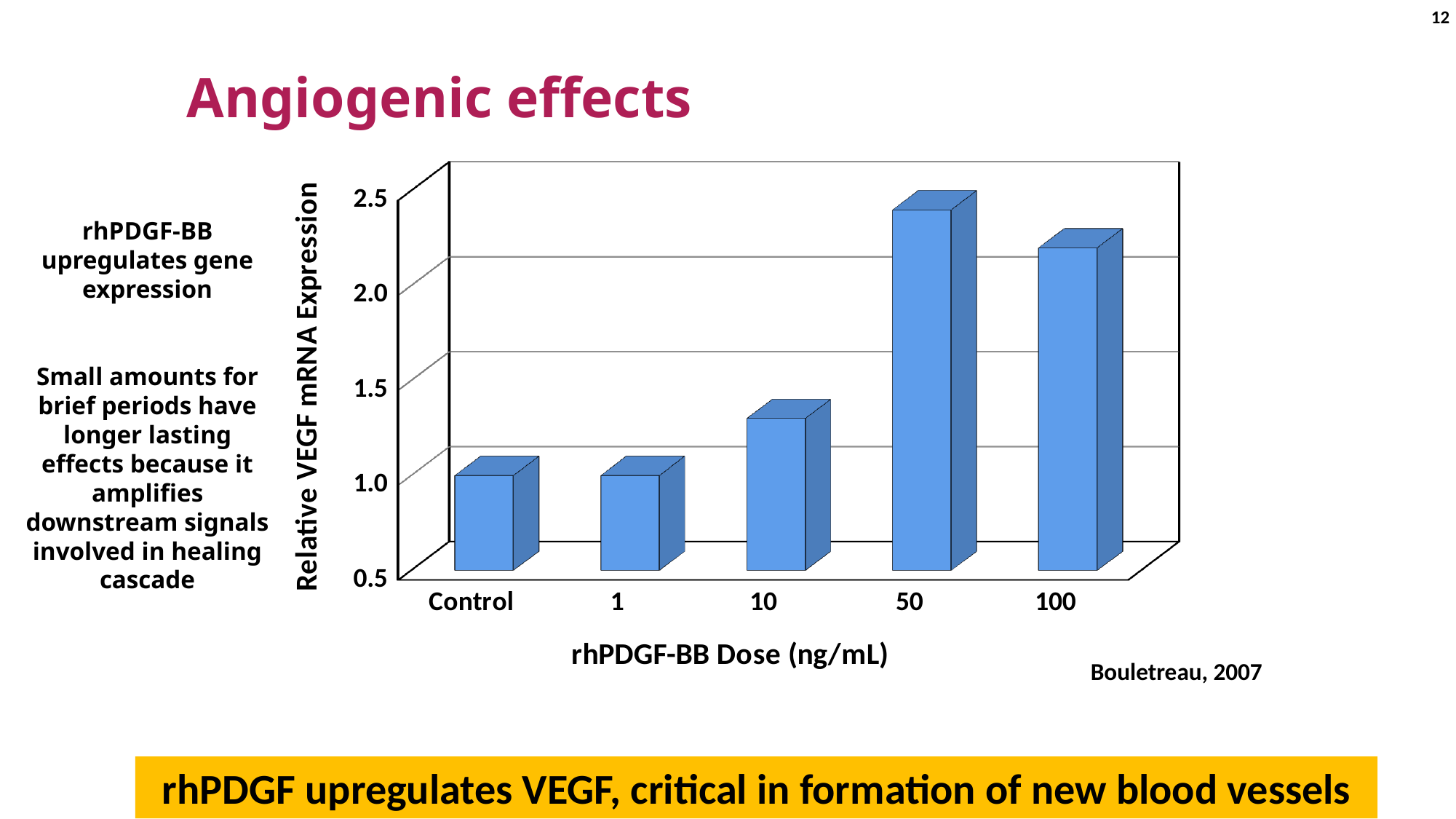
What is the label of the y axis? Relative VEGF mRNA Expression What kind of chart is shown on the slide? bar chart Which rhPDGF-BB dose has the highest relative VEGF mRNA expression? 50 Which is higher, the relative VEGF mRNA expression at 50 ng/mL or at 100 ng/mL? 50 Is the relative VEGF mRNA expression at 50 ng/mL greater or less than 2.0? greater How many dose categories are plotted on the x axis? 5 Is the relative VEGF mRNA expression at 10 ng/mL greater or less than 1.0? greater What is the label of the x axis? rhPDGF-BB Dose (ng/mL) Does relative VEGF mRNA expression generally rise or fall as the rhPDGF-BB dose increases from Control to 50 ng/mL? rise Which is higher, the relative VEGF mRNA expression at 10 ng/mL or at 100 ng/mL? 100 Is the relative VEGF mRNA expression at 10 ng/mL greater or less than 1.5? less